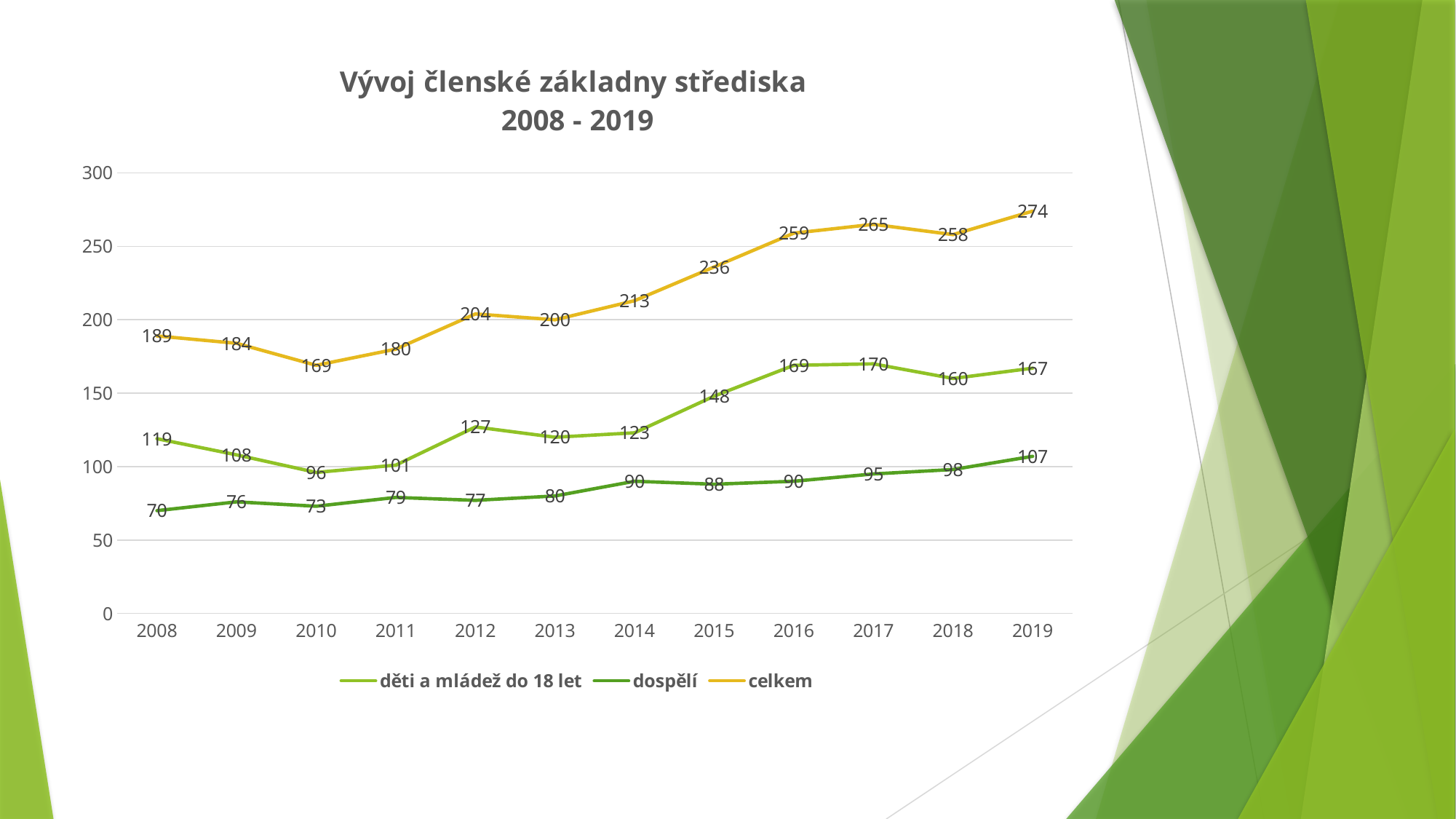
What is the value for 'děti a mládež do 18 let' in 2016? 169 In which year is the 'celkem' series at its lowest? 2010 How many years are shown on the x axis? 12 How many series does the legend list? 3 What is the value for 'celkem' in 2019? 274 What is the difference between the 'celkem' values for 2019 and 2008? 85 What kind of chart is shown on the slide? line chart Which is larger: 'děti a mládež do 18 let' in 2012 or in 2013? 2012 What is the value for 'dospělí' in 2008? 70 What is the title of the chart? Vývoj členské základny střediska 2008 - 2019 Does the 'dospělí' series generally rise or fall from 2008 to 2019? rise In which year is the 'děti a mládež do 18 let' series at its highest? 2017